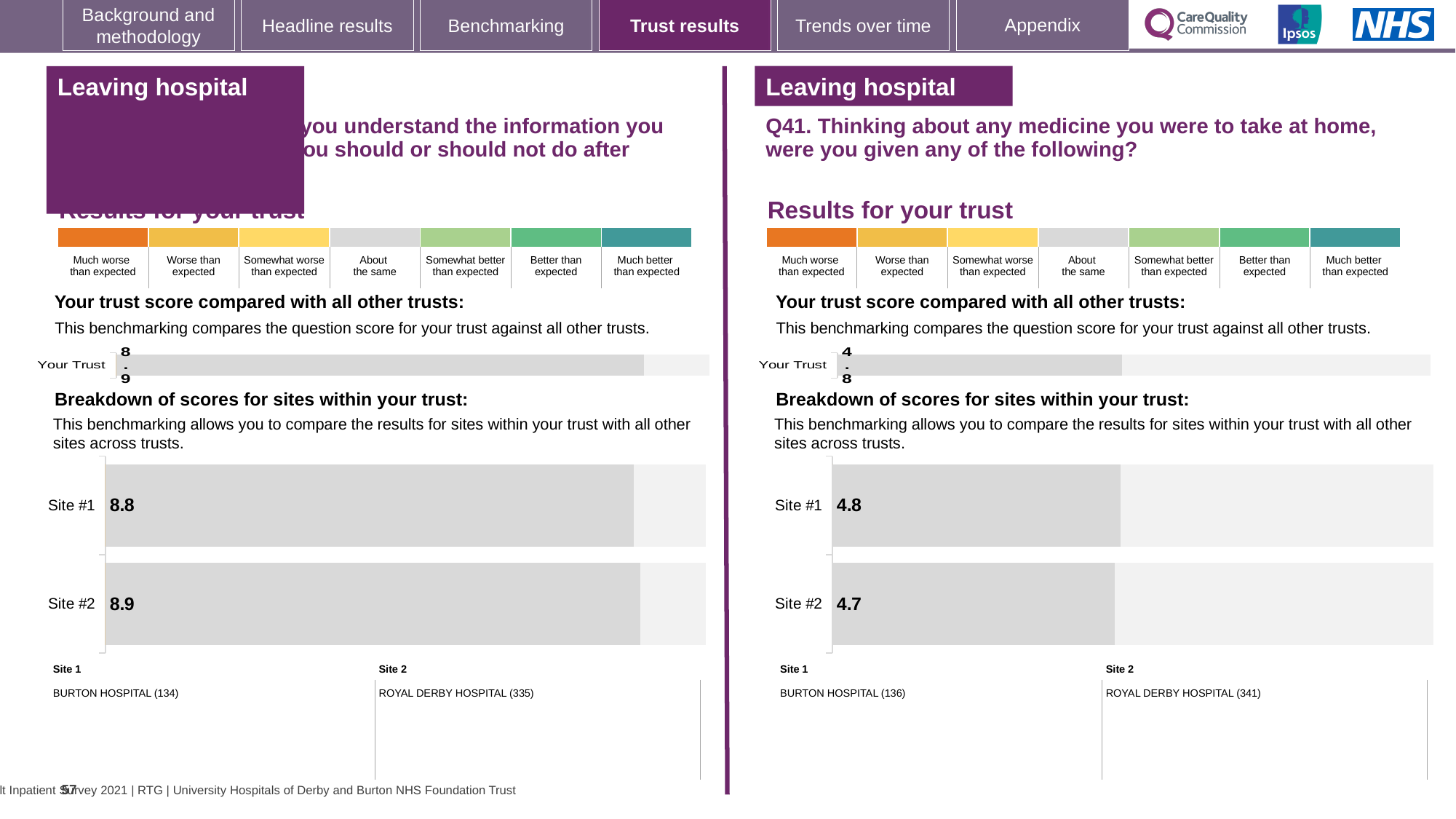
On the right-hand panel, which hospital is listed as Site 2? ROYAL DERBY HOSPITAL (341) On the right-hand (Q41) 'Your Trust' chart, what is the trust score shown? 4.8 On the right-hand (Q41) site breakdown chart, which site has the higher score? Site #1 On the left-hand site breakdown chart, which site has the lower score? Site #1 On the left-hand site breakdown chart, what is the score for Site #2? 8.9 On the left-hand site breakdown chart, what is the score for Site #1? 8.8 What type of chart is used for the site breakdown on the right-hand (Q41) panel? Bar chart On the right-hand (Q41) site breakdown chart, what is the score for Site #1? 4.8 On the left-hand 'Your Trust' chart, what is the trust score shown? 8.9 How many sites are shown on the left-hand site breakdown chart? 2 On the right-hand (Q41) site breakdown chart, what is the difference between the Site #1 and Site #2 scores? 0.1 On the right-hand (Q41) site breakdown chart, what is the score for Site #2? 4.7